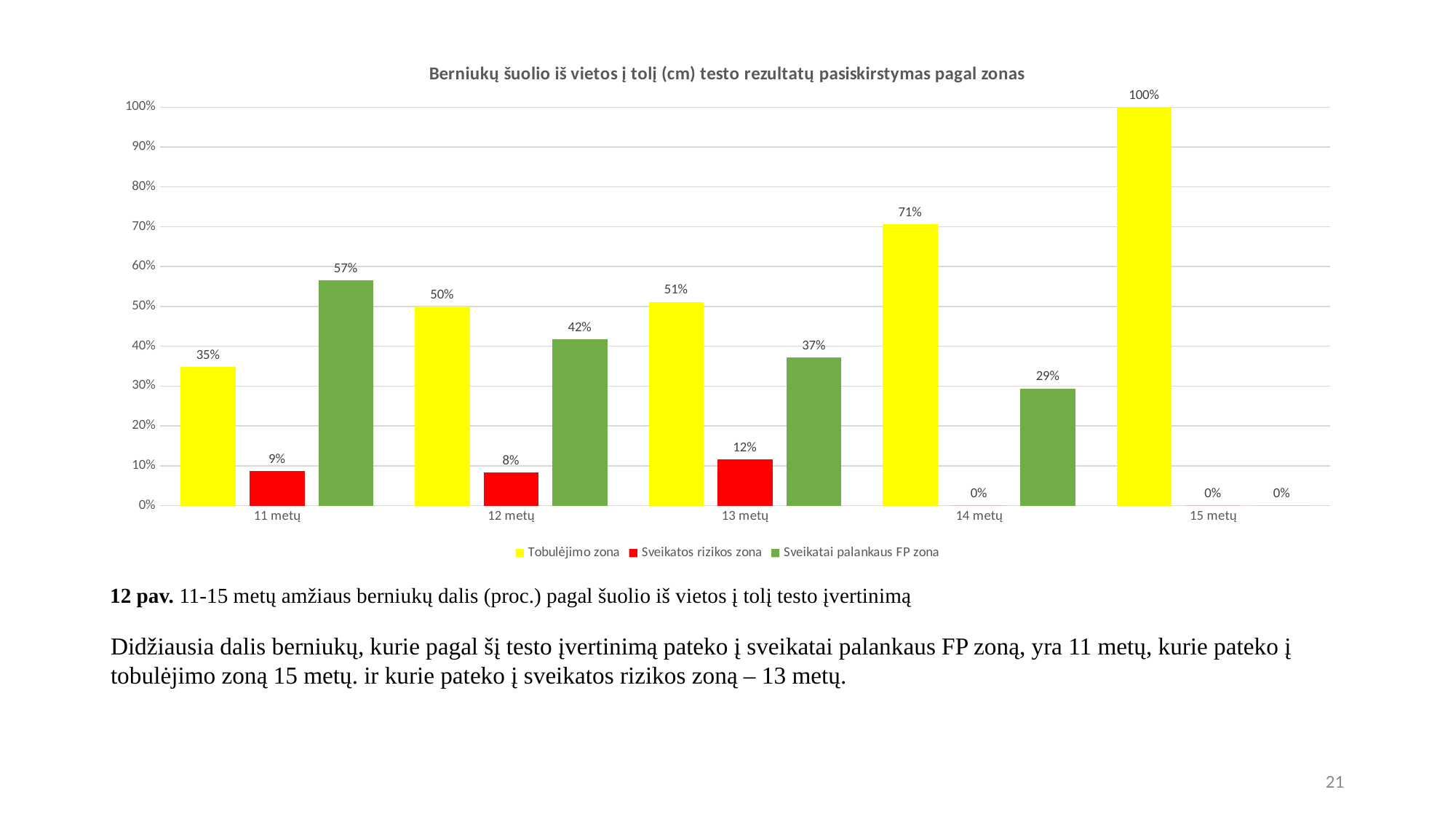
Which is larger at 12 metų: Tobulėjimo zona or Sveikatai palankaus FP zona? Tobulėjimo zona Does the Tobulėjimo zona series rise or fall from 11 metų to 15 metų? Rise How many series does the legend list? 3 What colour represents Sveikatos rizikos zona in the chart? Red What is the value for Sveikatos rizikos zona at 13 metų? 12% What is the value for Tobulėjimo zona at 11 metų? 35% What is the value for Sveikatai palankaus FP zona at 14 metų? 29% What is the difference between the Sveikatai palankaus FP zona values at 11 metų and 12 metų? 15% Which age group has the lowest value for Sveikatai palankaus FP zona? 15 metų What kind of chart is shown on the slide? Bar chart Which age group has the highest value for Tobulėjimo zona? 15 metų How many age groups are shown on the x axis? 5